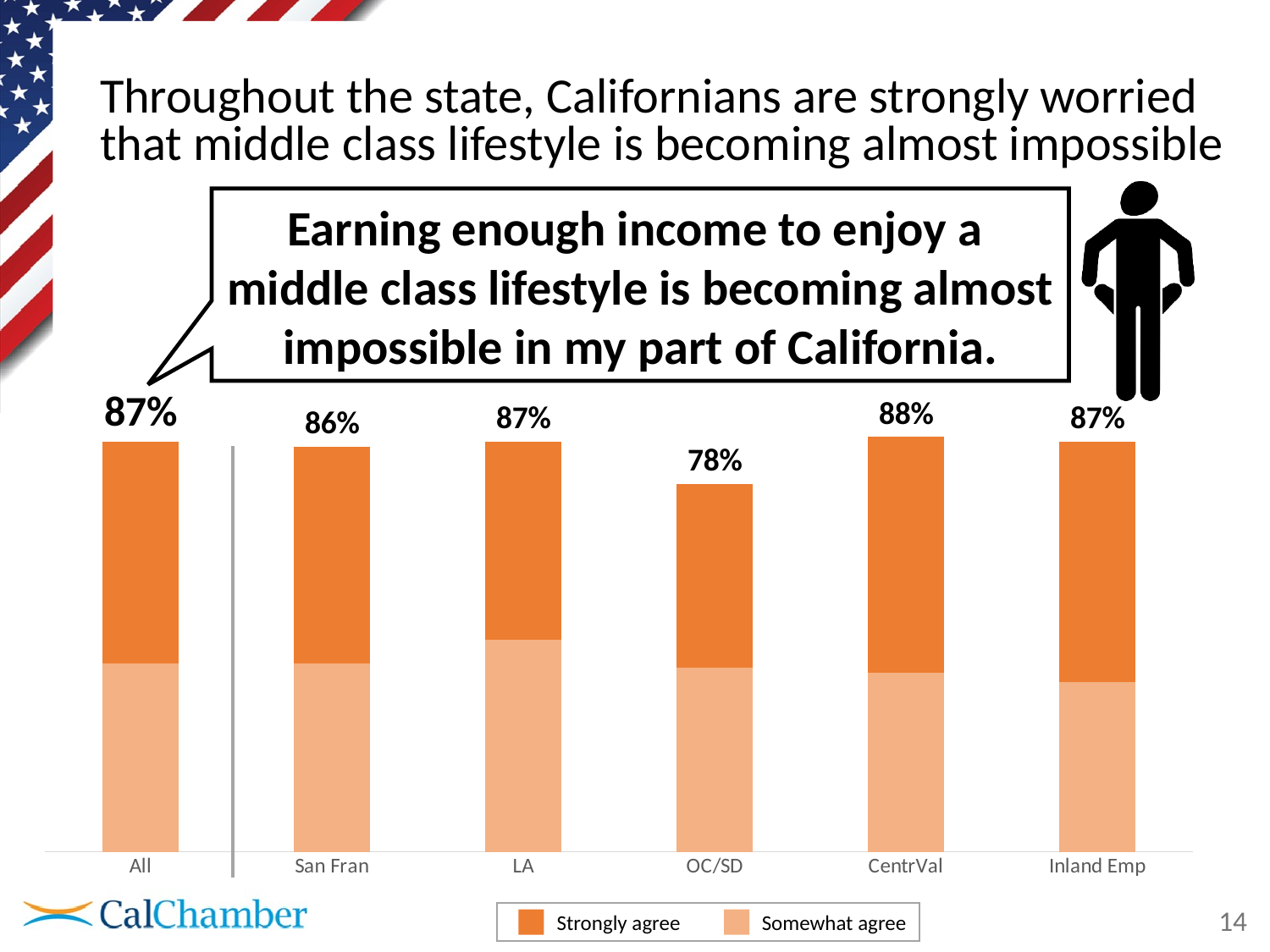
Which region has the lowest total percentage agreeing? OC/SD How many series does the legend list? 2 How many categories are shown on the x axis of the chart? 6 What is the total percentage shown for CentrVal? 88% What kind of chart is shown on the slide? Stacked bar chart What is the total percentage shown for the All category? 87% What is the total percentage shown for San Fran? 86% Which region has the highest total percentage agreeing? CentrVal What are the two series named in the legend? Strongly agree and Somewhat agree What is the total percentage shown for OC/SD? 78% Which has a higher total percentage, San Fran or Inland Emp? Inland Emp What is the difference between the total for CentrVal and the total for OC/SD? 10 percentage points